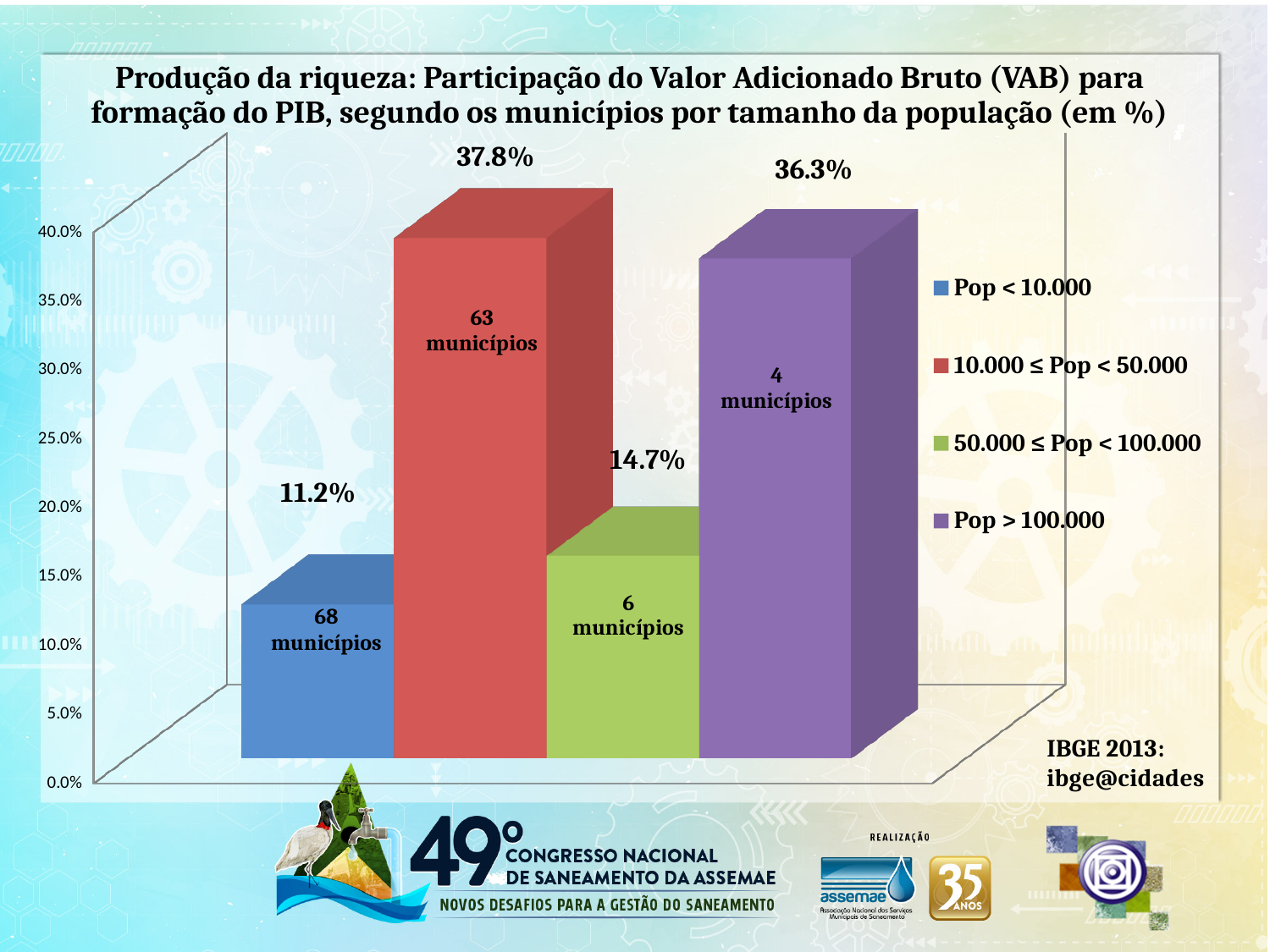
What is the VAB share for municipalities with 50.000 ≤ Pop < 100.000? 14.7% Which population group has the highest VAB share? 10.000 ≤ Pop < 50.000 What kind of chart is shown on the slide? Bar chart How many municipalities are in the Pop > 100.000 group, according to the label on the bar? 4 municípios What is the VAB share for municipalities with 10.000 ≤ Pop < 50.000? 37.8% What is the difference between the VAB share of the 10.000 ≤ Pop < 50.000 group and the Pop > 100.000 group? 1.5% Which population group has the lowest VAB share? Pop < 10.000 What is the VAB share for municipalities with Pop > 100.000? 36.3% What is the VAB share for municipalities with Pop < 10.000? 11.2% Which has a larger VAB share: the Pop < 10.000 group or the 50.000 ≤ Pop < 100.000 group? 50.000 ≤ Pop < 100.000 How many entries does the legend list? 4 How many population groups (bars) are shown in the chart? 4